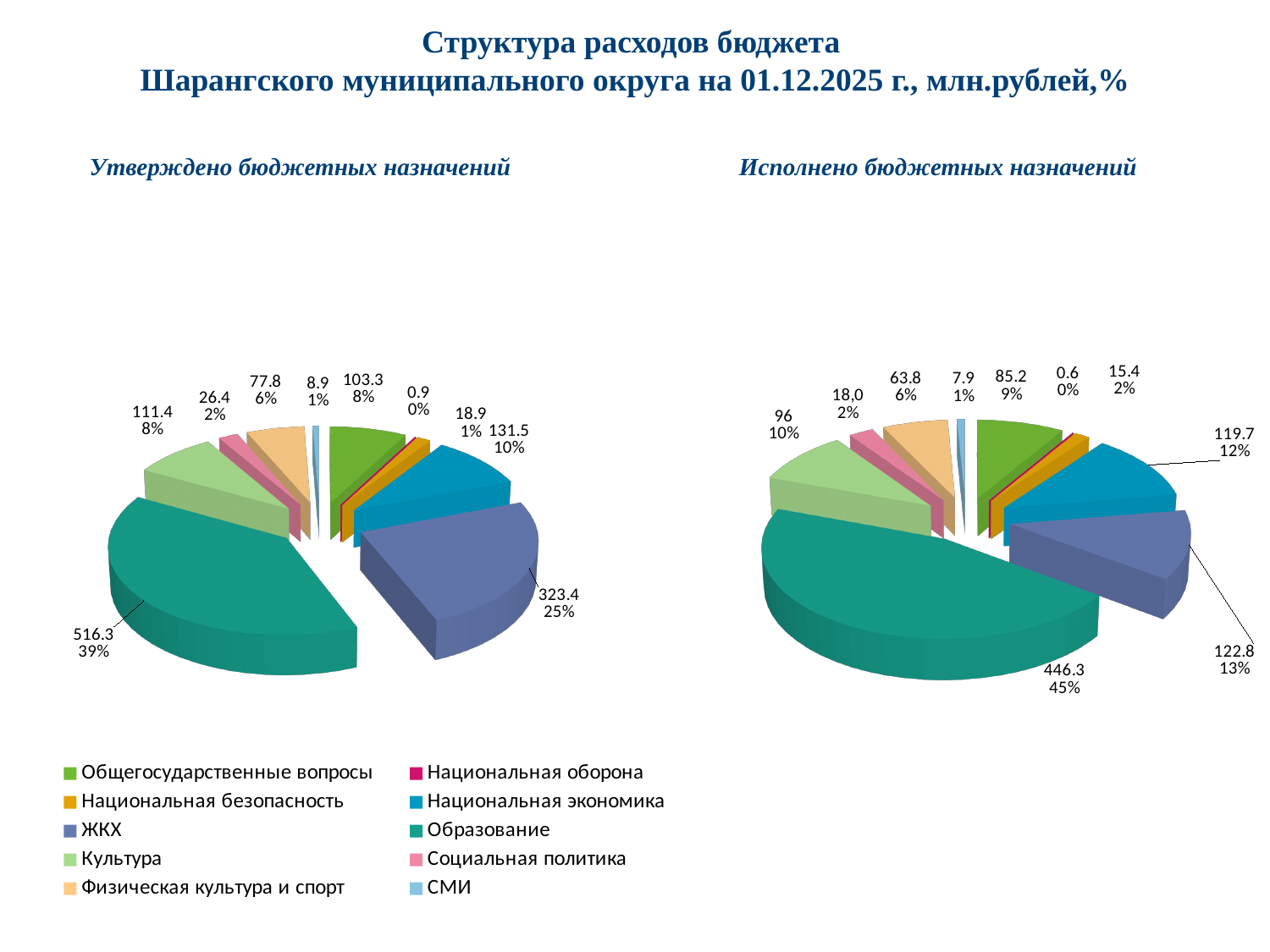
What type of chart is used on this slide? Pie chart On the 'Утверждено бюджетных назначений' chart, which category has the largest slice? Образование On the 'Исполнено бюджетных назначений' chart, what is the value for ЖКХ? 122.8 What colour represents Образование in the legend? Teal (green) On the 'Исполнено бюджетных назначений' chart, what share of the pie does Образование represent? 45% On the 'Исполнено бюджетных назначений' chart, which is larger: Культура or Физическая культура и спорт? Культура How many categories does the legend list? 10 On the 'Исполнено бюджетных назначений' chart, which category has the smallest slice? Национальная оборона On the 'Утверждено бюджетных назначений' chart, what share of the pie does ЖКХ represent? 25% On the 'Утверждено бюджетных назначений' chart, what is the value for Образование? 516.3 On the 'Утверждено бюджетных назначений' chart, what is the difference between the values for Образование and ЖКХ? 192.9 On the 'Исполнено бюджетных назначений' chart, what is the value for Национальная экономика? 119.7